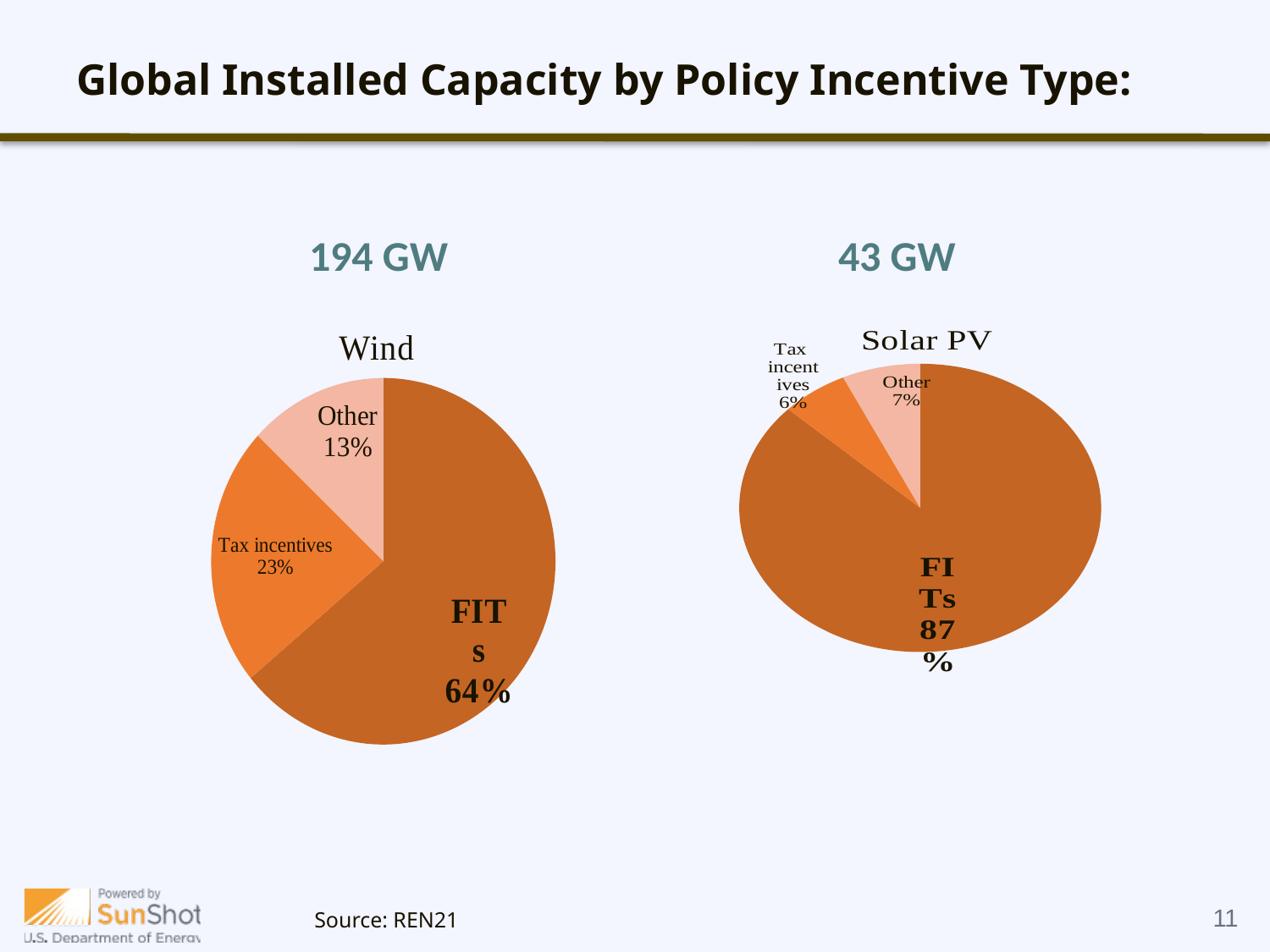
In the Solar PV pie chart, what share of installed capacity is attributed to FITs? 87% In the Wind pie chart, how many percentage points larger is the FITs share than the Tax incentives share? 41 In the Wind pie chart, which policy incentive type has the largest share? FITs What type of chart is used to show the Wind data? Pie chart In the Wind pie chart, what share is attributed to Other? 13% In the Solar PV pie chart, what share is attributed to Other? 7% In the Solar PV pie chart, what share is attributed to Tax incentives? 6% Which chart shows a larger share for FITs, Wind or Solar PV? Solar PV In the Solar PV pie chart, which policy incentive type has the smallest share? Tax incentives In the Wind pie chart, what share is attributed to Tax incentives? 23% How many slices does the Solar PV pie chart have? 3 In the Wind pie chart, what share of installed capacity is attributed to FITs? 64%